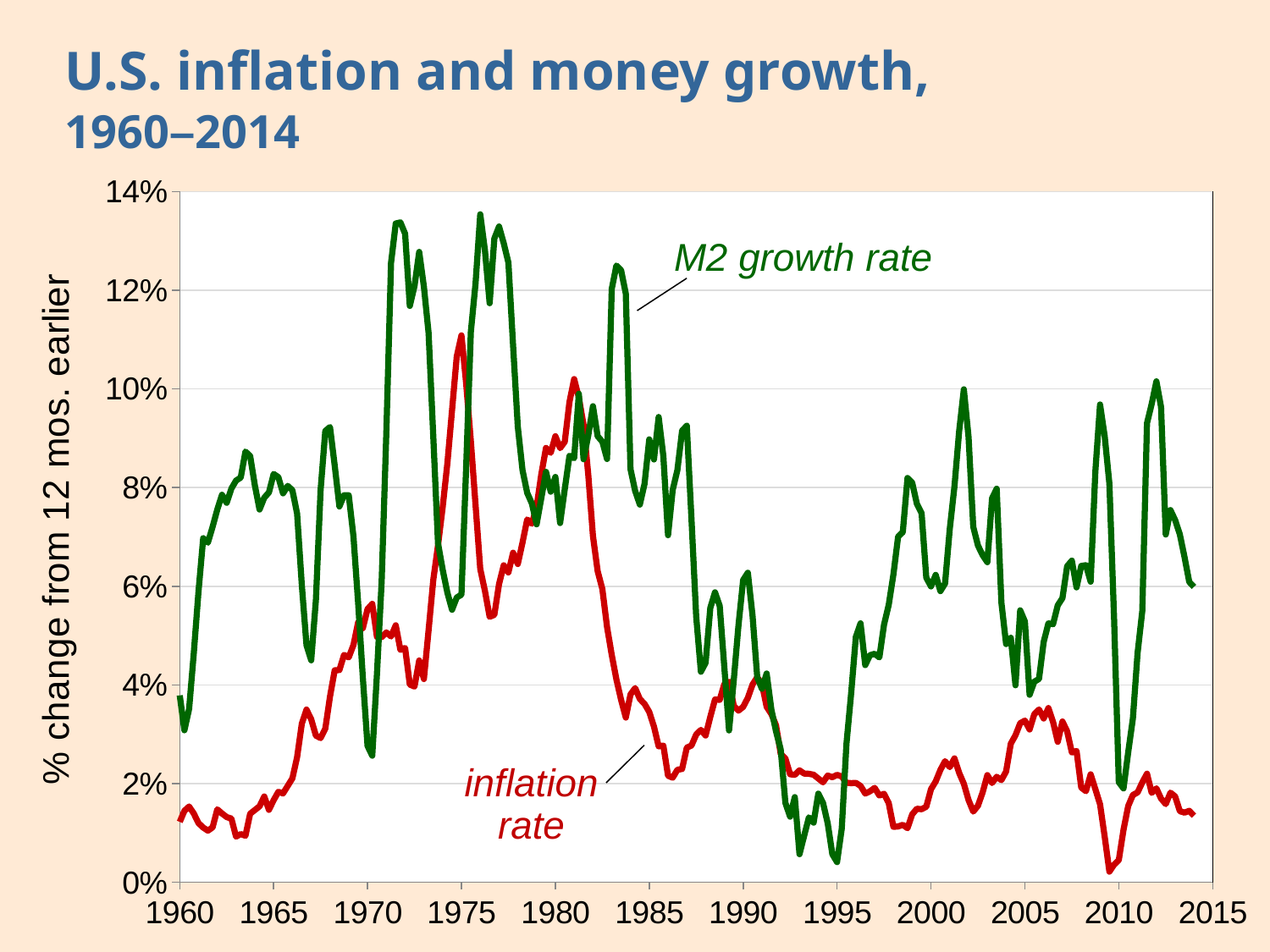
How many series are plotted on the chart? 2 What kind of chart is shown on the slide? line chart Is the M2 growth rate in 1995 greater or less than 2%? less Is the peak of the inflation rate around 1975 greater or less than 10%? greater What is the title of the chart on the slide? U.S. inflation and money growth, 1960–2014 In 1975, which series is higher, the inflation rate or the M2 growth rate? inflation rate Does the inflation rate generally rise or fall between 1980 and 1985? fall Is the M2 growth rate at its 1972 peak greater or less than 12%? greater Which series reaches the highest value anywhere on the chart? M2 growth rate In 2009, which series is higher, the M2 growth rate or the inflation rate? M2 growth rate What is the label on the vertical axis of the chart? % change from 12 mos. earlier